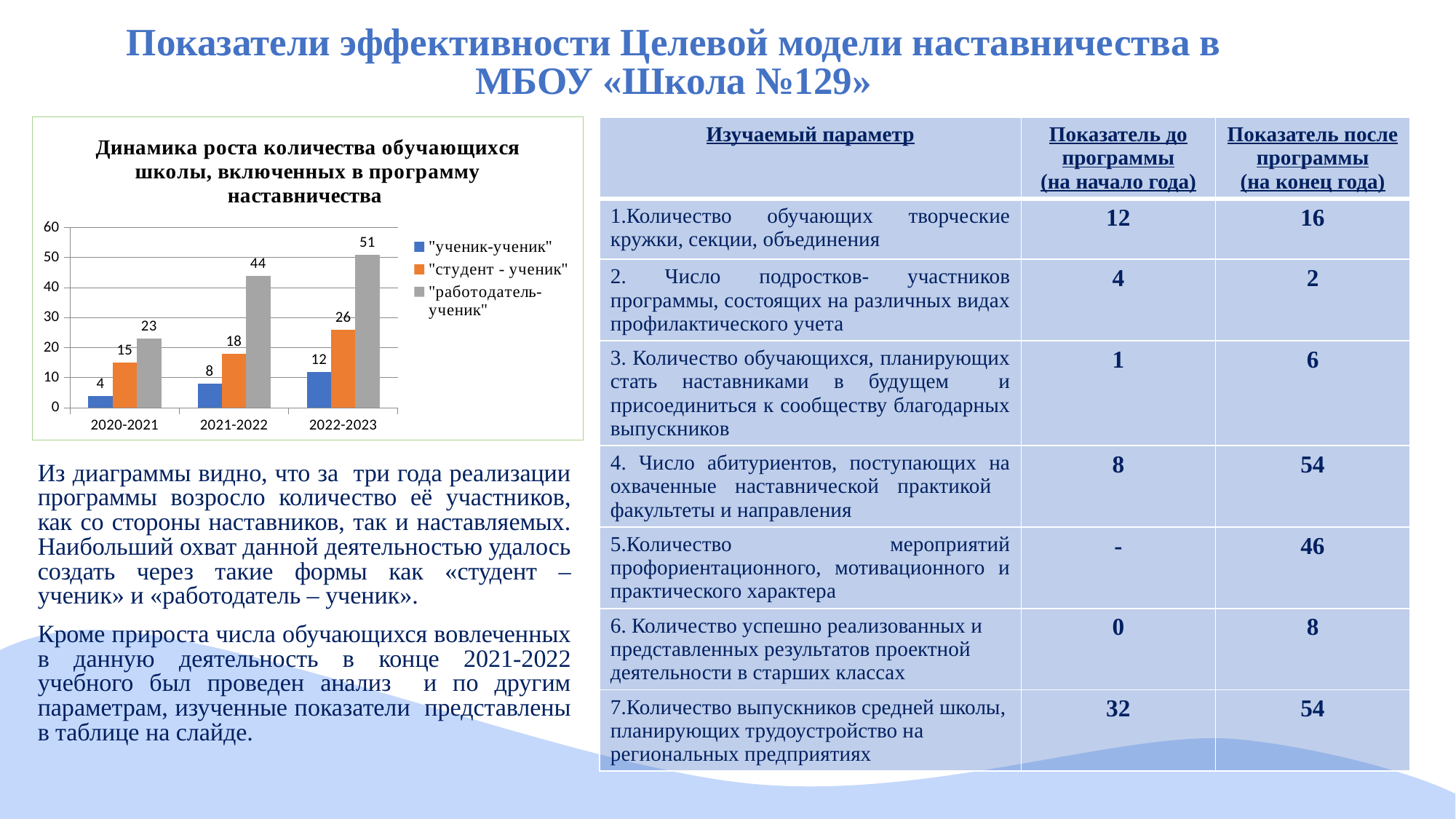
How many series does the legend list? 3 How many year categories are shown on the x axis? 3 What is the difference between the "работодатель-ученик" values for 2021-2022 and 2020-2021? 21 Which is larger in 2022-2023: "ученик-ученик" or "студент - ученик"? "студент - ученик" What is the title of the chart? Динамика роста количества обучающихся школы, включенных в программу наставничества Which year has the lowest value for "студент - ученик"? 2020-2021 What is the value for "работодатель-ученик" in 2022-2023? 51 What is the value for "ученик-ученик" in 2020-2021? 4 What type of chart is shown on the slide? bar chart What is the value for "студент - ученик" in 2021-2022? 18 Which year has the highest value for "работодатель-ученик"? 2022-2023 Do the values for "ученик-ученик" rise or fall from 2020-2021 to 2022-2023? rise